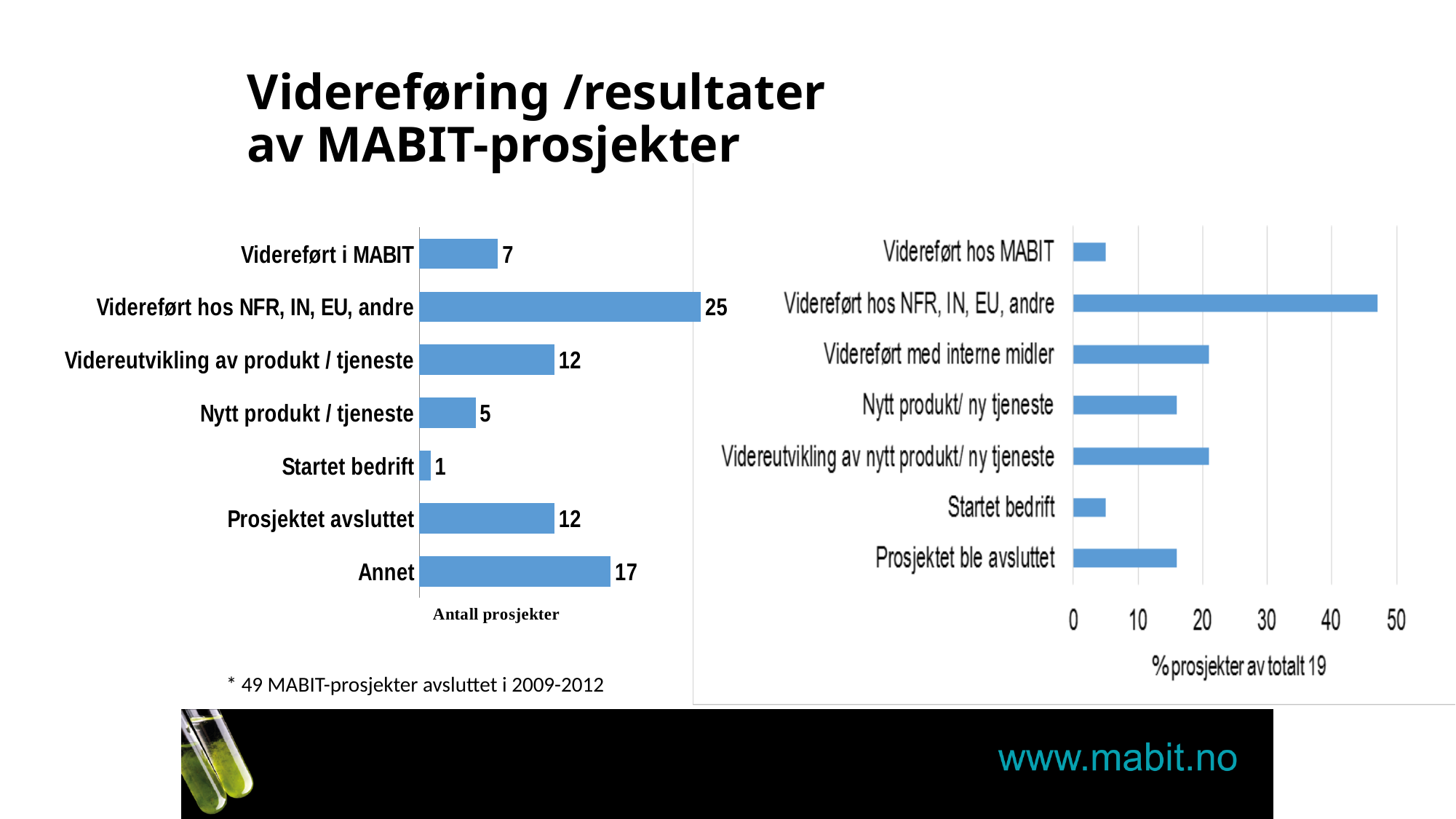
In the left chart (Antall prosjekter), what is the value for Startet bedrift? 1 How many categories does the left chart (Antall prosjekter) show? 7 In the left chart (Antall prosjekter), which category has the highest value? Videreført hos NFR, IN, EU, andre In the left chart (Antall prosjekter), which is larger: Annet or Videreutvikling av produkt / tjeneste? Annet In the left chart (Antall prosjekter), what is the value for Annet? 17 In the right chart (% prosjekter av totalt 19), is the value for Startet bedrift greater or less than 10? less In the left chart (Antall prosjekter), what is the value for Videreført hos NFR, IN, EU, andre? 25 What kind of chart is the right chart (% prosjekter av totalt 19)? bar chart In the right chart (% prosjekter av totalt 19), which category has the highest value? Videreført hos NFR, IN, EU, andre In the left chart (Antall prosjekter), which category has the lowest value? Startet bedrift In the right chart (% prosjekter av totalt 19), is the value for Videreført hos NFR, IN, EU, andre greater or less than 40? greater In the left chart (Antall prosjekter), what is the difference between Videreført hos NFR, IN, EU, andre and Videreført i MABIT? 18